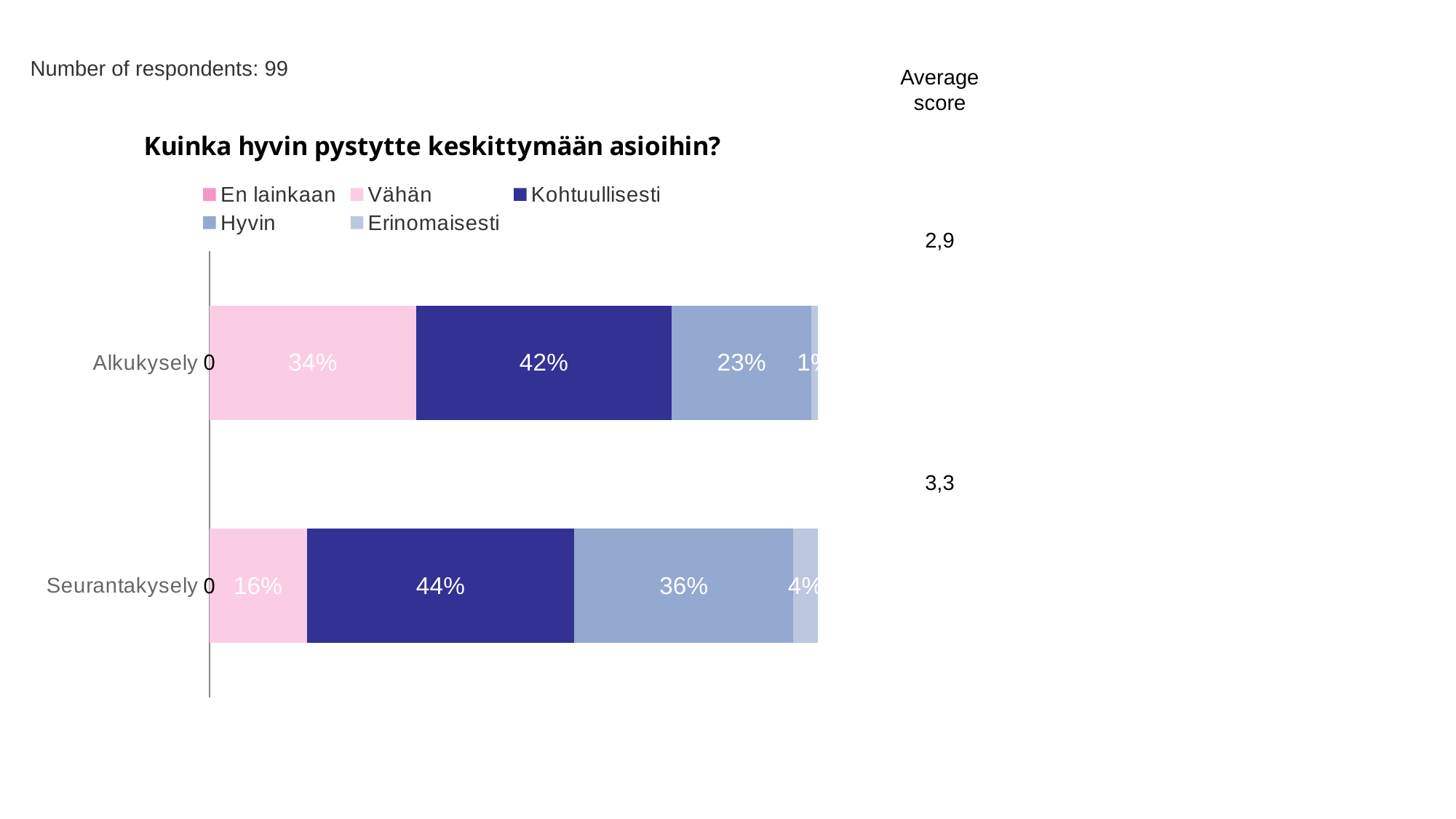
How many series does the legend list? 5 What is the value for Hyvin in the Alkukysely bar? 23% What is the title of the chart? Kuinka hyvin pystytte keskittymään asioihin? By how many percentage points is the Vähän share in Alkukysely larger than in Seurantakysely? 18 percentage points Is the Vähän share larger in Alkukysely or in Seurantakysely? Alkukysely Which response option has the largest share in the Seurantakysely bar? Kohtuullisesti By how many percentage points does the Hyvin share in Seurantakysely exceed the Hyvin share in Alkukysely? 13 percentage points What is the value for Erinomaisesti in the Seurantakysely bar? 4% What is the value for Kohtuullisesti in the Seurantakysely bar? 44% What is the value for Vähän in the Alkukysely bar? 34% What kind of chart is shown on the slide? bar chart How many categories (survey rounds) are plotted on the chart? 2